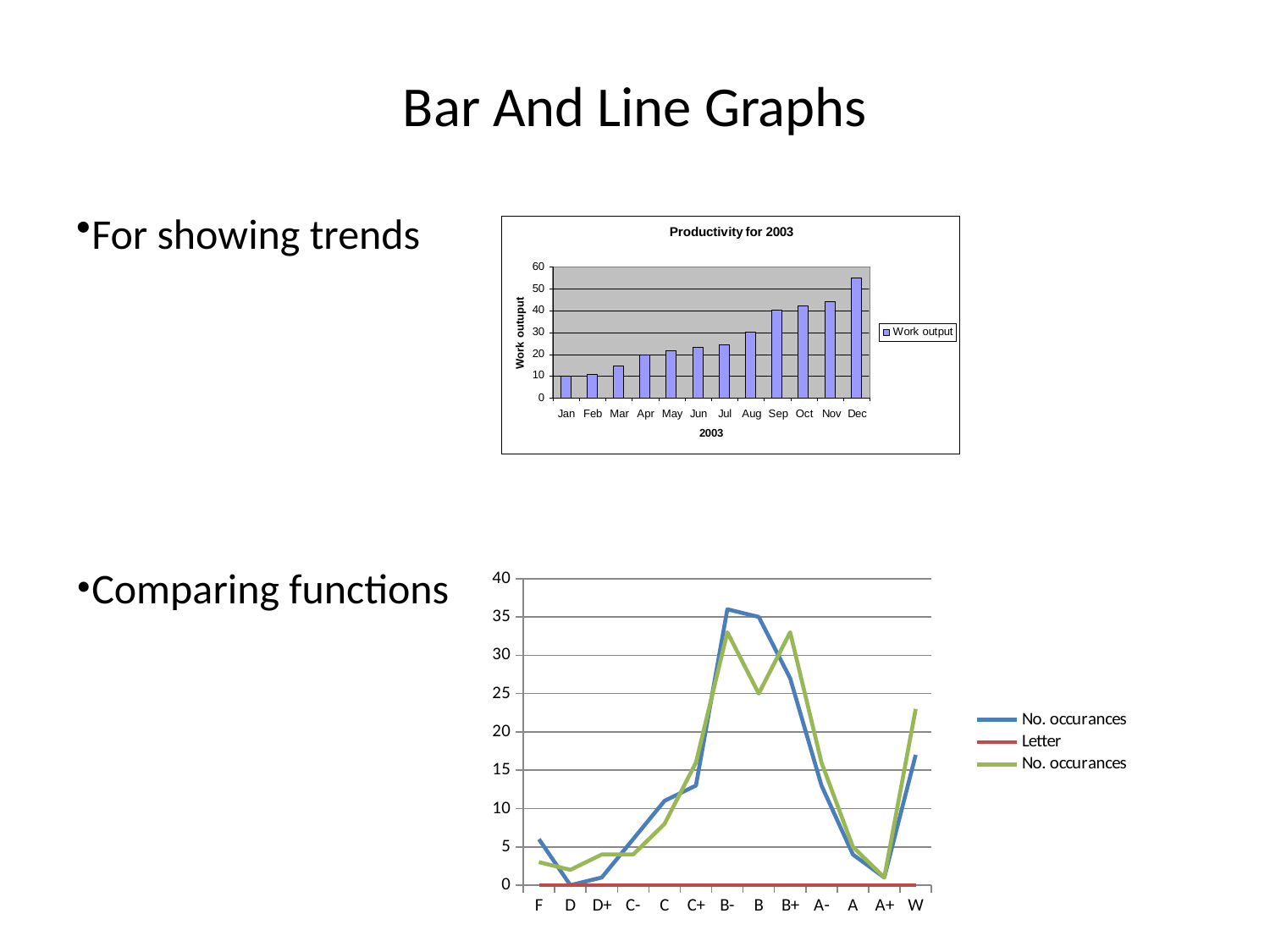
In the bottom chart, how many categories are shown on the x axis? 13 In the 'Productivity for 2003' chart, how many months are shown on the x axis? 12 In the bottom chart, is the value of the blue 'No. occurances' line at B- greater or less than 30? greater In the 'Productivity for 2003' chart, do the values rise or fall from Jan to Dec? rise How many series does the legend of the bottom chart list? 3 In the 'Productivity for 2003' chart, is the value for Mar greater or less than 20? less In the 'Productivity for 2003' chart, which is larger, the value for Aug or the value for Apr? Aug What type of chart is the 'Productivity for 2003' chart? bar chart In the 'Productivity for 2003' chart, is the value for Sep greater or less than 30? greater In the 'Productivity for 2003' chart, which month has the highest work output? Dec What type of chart is the bottom chart on the slide? line chart In the 'Productivity for 2003' chart, which month has the lowest work output? Jan